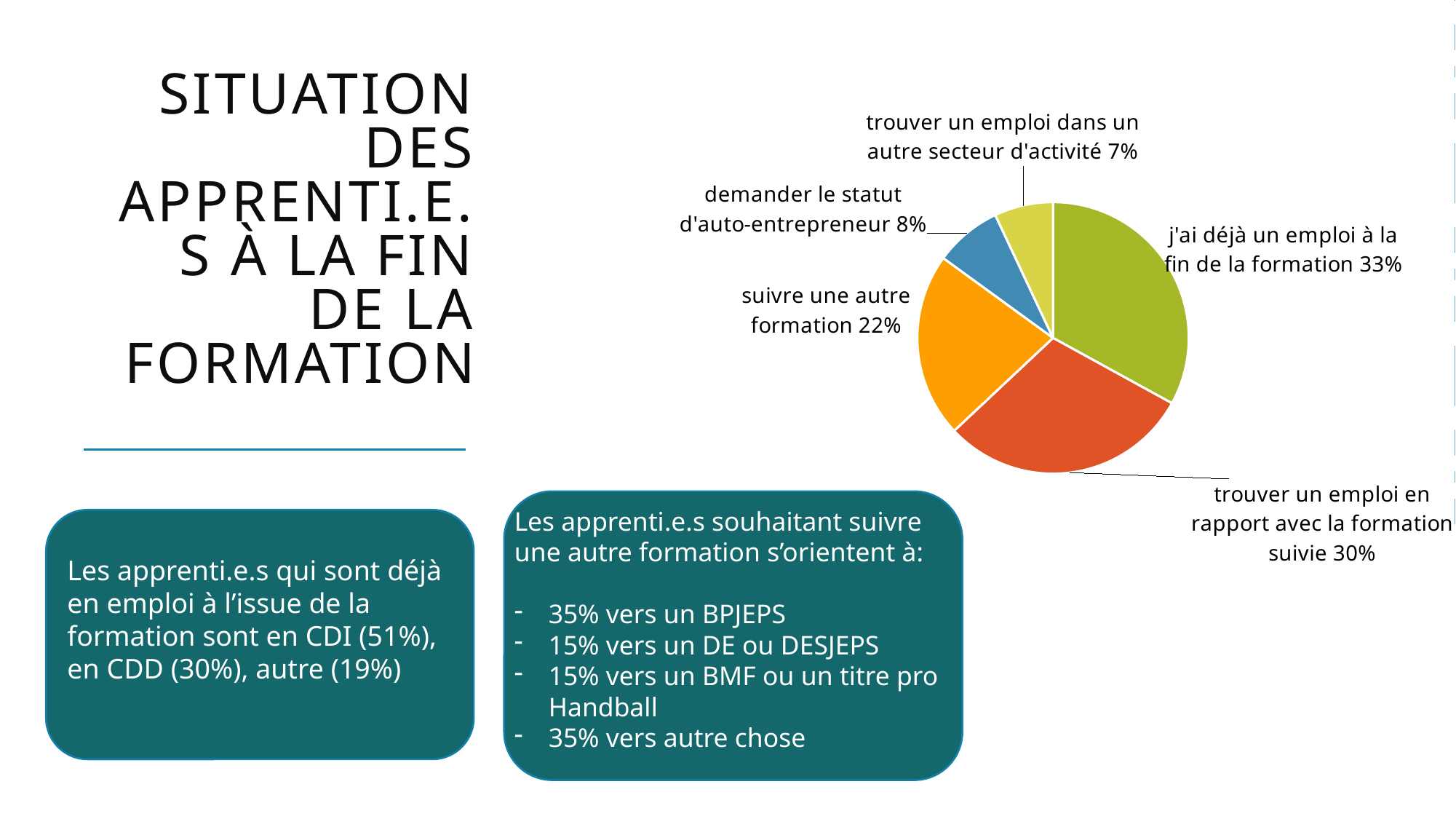
What share of the pie is 'j'ai déjà un emploi à la fin de la formation'? 33% What colour is the slice for 'suivre une autre formation'? orange What share of the pie is 'suivre une autre formation'? 22% What share of the pie is 'demander le statut d'auto-entrepreneur'? 8% How many slices does the pie chart have? 5 Which category has the smallest slice of the pie? trouver un emploi dans un autre secteur d'activité What is the difference in percentage points between 'j'ai déjà un emploi à la fin de la formation' and 'suivre une autre formation'? 11 What kind of chart is shown on the slide? pie chart Which category has the largest slice of the pie? j'ai déjà un emploi à la fin de la formation Which is larger: 'trouver un emploi en rapport avec la formation suivie' or 'suivre une autre formation'? trouver un emploi en rapport avec la formation suivie